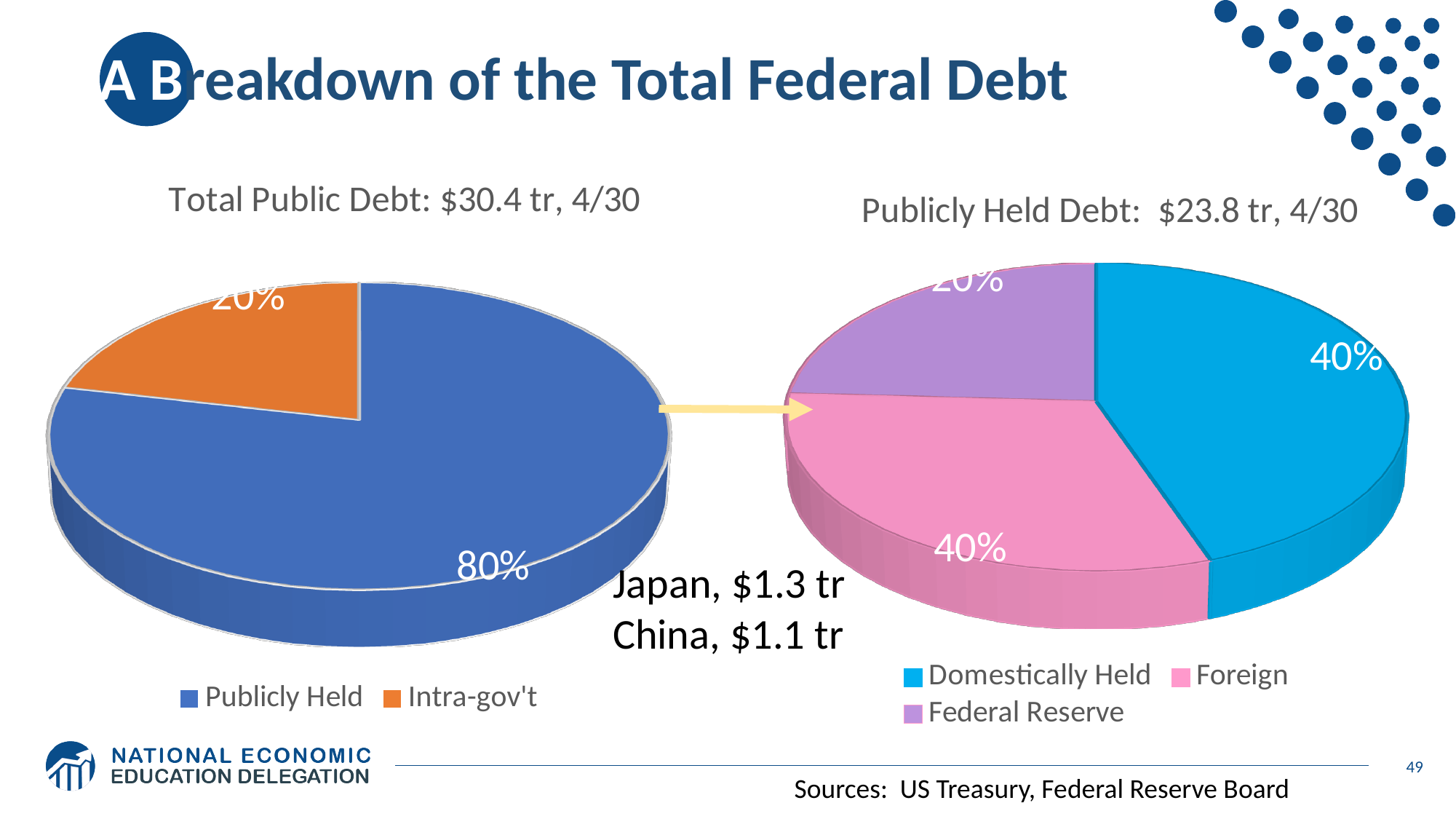
How many slices does the "Total Public Debt" chart have? 2 In the "Publicly Held Debt" chart, what share of the pie is Federal Reserve? 20% In the "Publicly Held Debt" chart, what is the difference in percentage points between the Foreign slice and the Federal Reserve slice? 20 What total amount is stated in the title of the "Publicly Held Debt" chart? $23.8 tr In the "Total Public Debt" chart, what share of the pie is Publicly Held? 80% In the "Publicly Held Debt" chart, which slice is the smallest? Federal Reserve In the "Publicly Held Debt" chart, what share of the pie is Domestically Held? 40% In the "Total Public Debt" chart, which is larger, Publicly Held or Intra-gov't? Publicly Held In the "Total Public Debt" chart, which slice is the largest? Publicly Held How many categories does the legend of the "Publicly Held Debt" chart list? 3 What kind of chart is the "Total Public Debt" chart on the left? pie chart